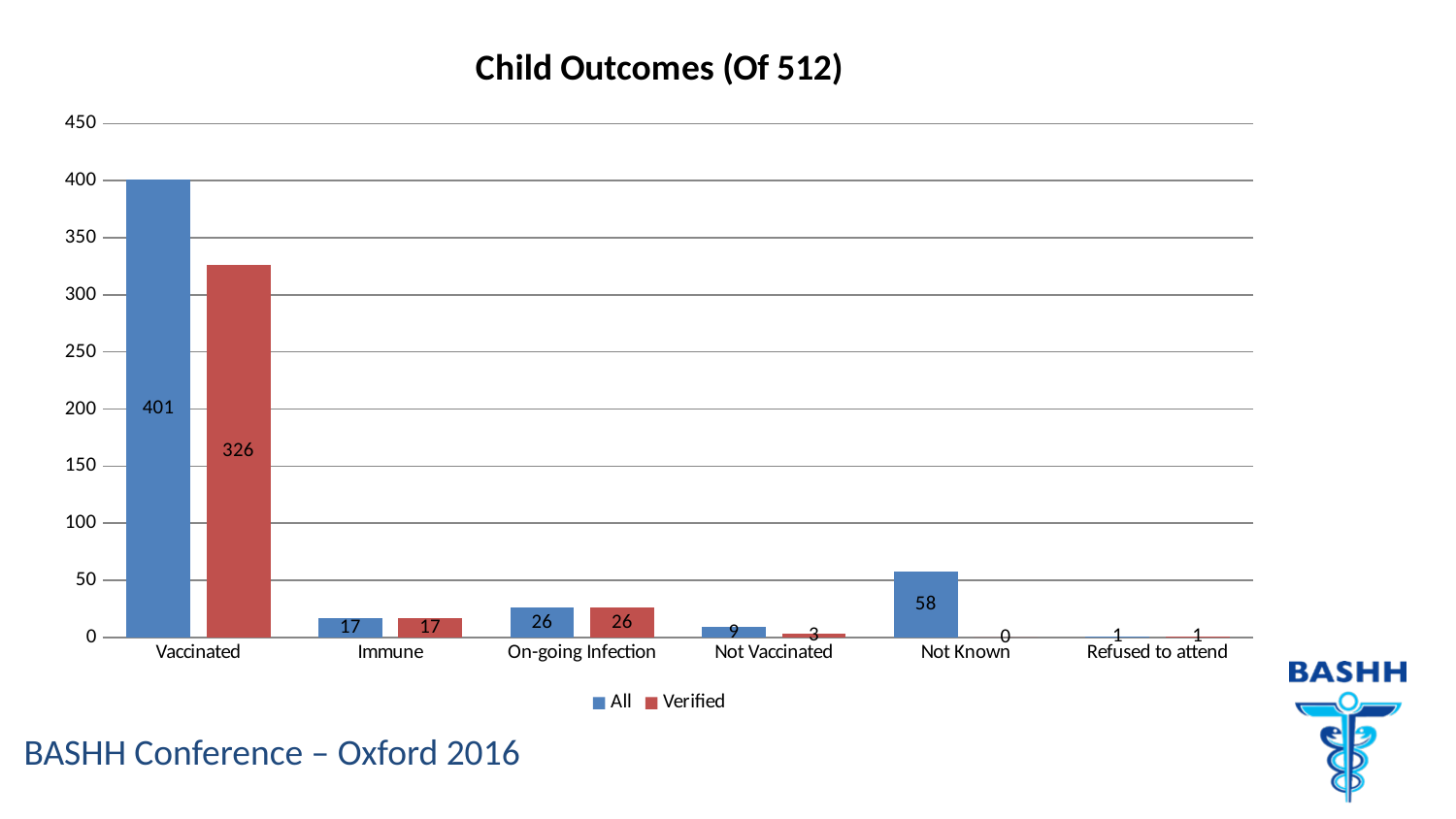
What kind of chart is shown on the slide? Bar chart What is the difference between the All and Verified values for Vaccinated? 75 What is the Verified value for Not Vaccinated? 3 Which category has the highest All value? Vaccinated What is the value for All in the Vaccinated category? 401 How many categories are shown on the x axis? 6 What is the Verified value for Vaccinated? 326 What is the title of the chart? Child Outcomes (Of 512) Which is larger, the All value for Not Known or the All value for On-going Infection? Not Known How many series does the legend list? 2 Which category has the lowest Verified value? Not Known What is the All value for Not Known? 58